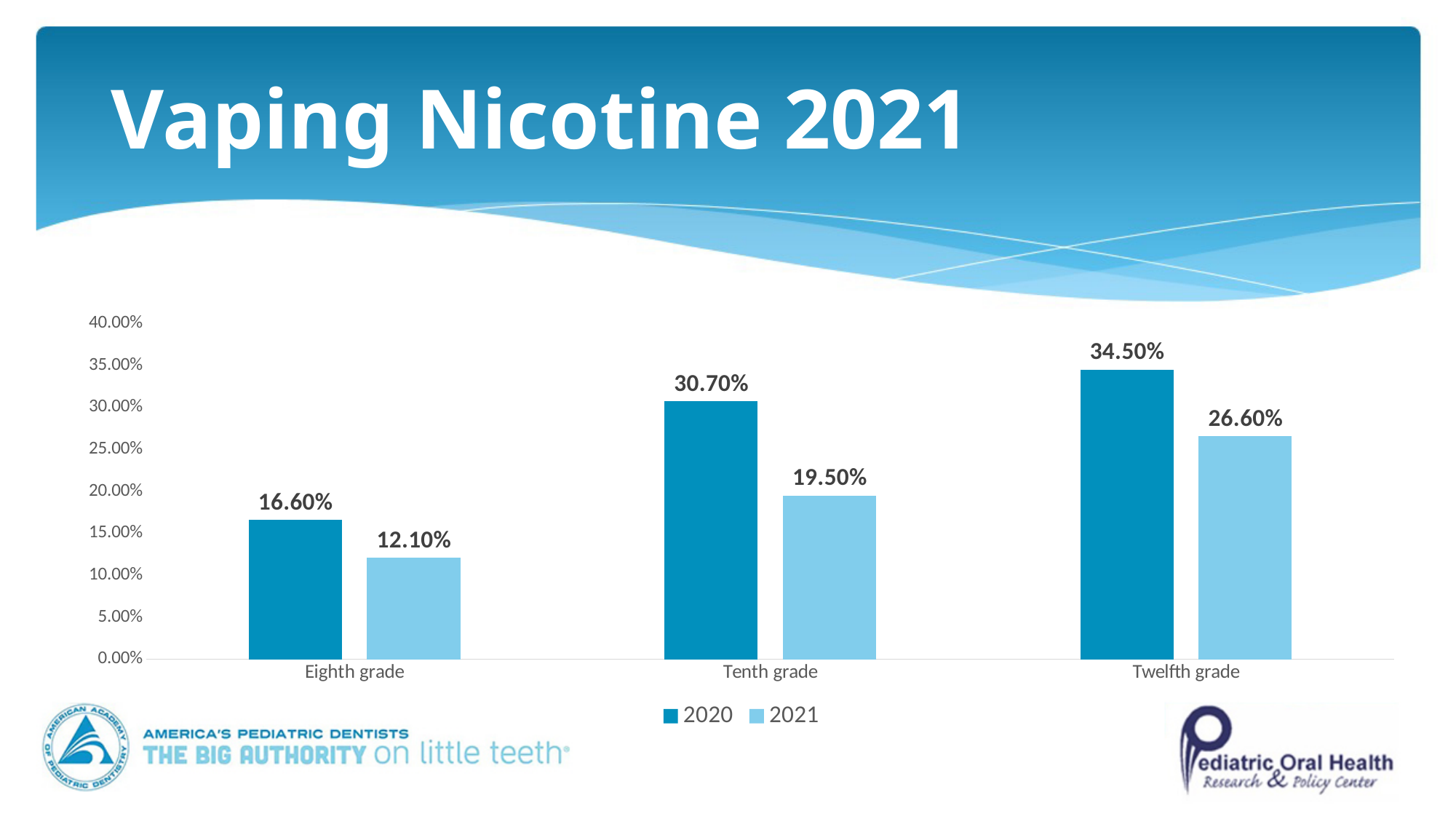
What is the 2021 value for Eighth grade? 12.10% Which grade has the lowest 2021 value? Eighth grade What kind of chart is shown on the slide? Bar chart How many grade categories are shown on the x axis? 3 Which grade has the highest 2020 value? Twelfth grade How many series does the legend list? 2 Which is larger for Twelfth grade, the 2020 value or the 2021 value? 2020 What is the 2020 value for Tenth grade? 30.70% What is the 2021 value for Twelfth grade? 26.60% Is the 2020 value for Eighth grade greater or less than 20.00%? less Do the 2021 values rise or fall from Eighth grade to Twelfth grade? Rise What is the difference between the 2020 and 2021 values for Tenth grade? 11.20%